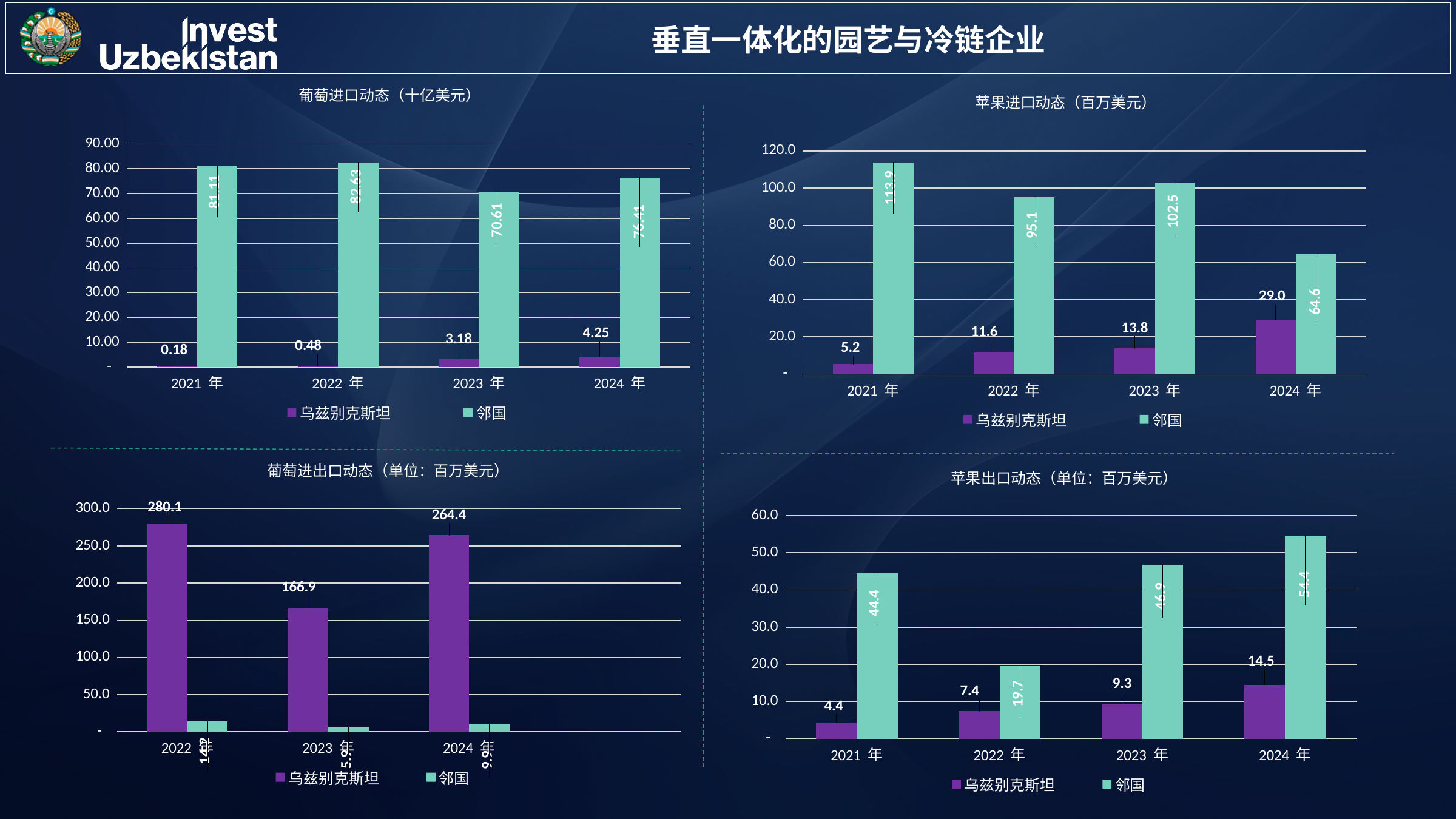
In the 苹果进口动态（百万美元） chart, what is the value for 邻国 in 2021 年? 113.9 In the 葡萄进口动态（十亿美元） chart, what is the value for 邻国 in 2022 年? 82.63 In the 葡萄进出口动态（单位：百万美元） chart, what is the value for 乌兹别克斯坦 in 2023 年? 166.9 In the 苹果出口动态（单位：百万美元） chart, which is larger: the 邻国 value in 2022 年 or the 乌兹别克斯坦 value in 2024 年? 邻国 in 2022 年 How many series does the legend of the 苹果出口动态（单位：百万美元） chart list? 2 In the 葡萄进口动态（十亿美元） chart, what is the value for 乌兹别克斯坦 in 2024 年? 4.25 In the 苹果进口动态（百万美元） chart, what is the difference between the 邻国 and 乌兹别克斯坦 values in 2024 年? 35.6 In the 葡萄进出口动态（单位：百万美元） chart, how many years are shown on the x axis? 3 In the 葡萄进口动态（十亿美元） chart, which year has the lowest value for 邻国? 2023 年 In the 苹果进口动态（百万美元） chart, do the 乌兹别克斯坦 values rise or fall from 2021 年 to 2024 年? rise In the 苹果出口动态（单位：百万美元） chart, what is the value for 邻国 in 2024 年? 54.4 In the 葡萄进出口动态（单位：百万美元） chart, which year has the highest value for 乌兹别克斯坦? 2022 年